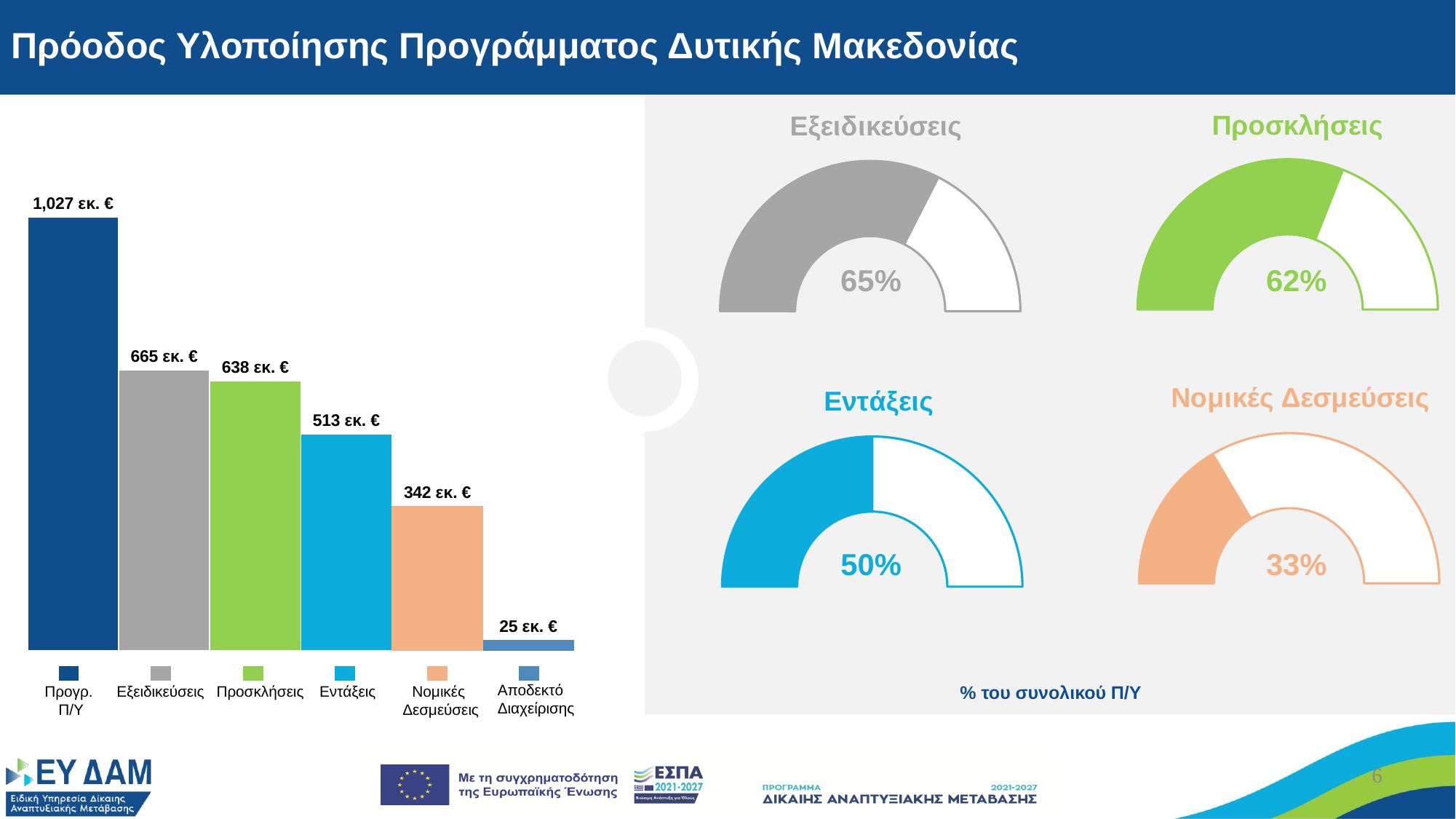
In the bar chart on the left, which category has the highest value? Προγρ. Π/Υ In the bar chart on the left, how many bars are shown? 6 In the bar chart on the left, what is the value for Εντάξεις? 513 εκ. € In the bar chart on the left, do the values rise or fall from left to right? fall What kind of chart is shown on the left of the slide? bar chart In the gauge chart titled Νομικές Δεσμεύσεις, what percentage is shown? 33% In the bar chart on the left, what is the difference between Εντάξεις and Νομικές Δεσμεύσεις? 171 εκ. € In the bar chart on the left, which category has the lowest value? Αποδεκτό Διαχείρισης In the bar chart on the left, what is the value for Προγρ. Π/Υ? 1,027 εκ. € In the bar chart on the left, what is the difference between Εξειδικεύσεις and Προσκλήσεις? 27 εκ. € Among the four gauge charts on the right, which one shows the highest percentage? Εξειδικεύσεις In the bar chart on the left, what is the value for Αποδεκτό Διαχείρισης? 25 εκ. €